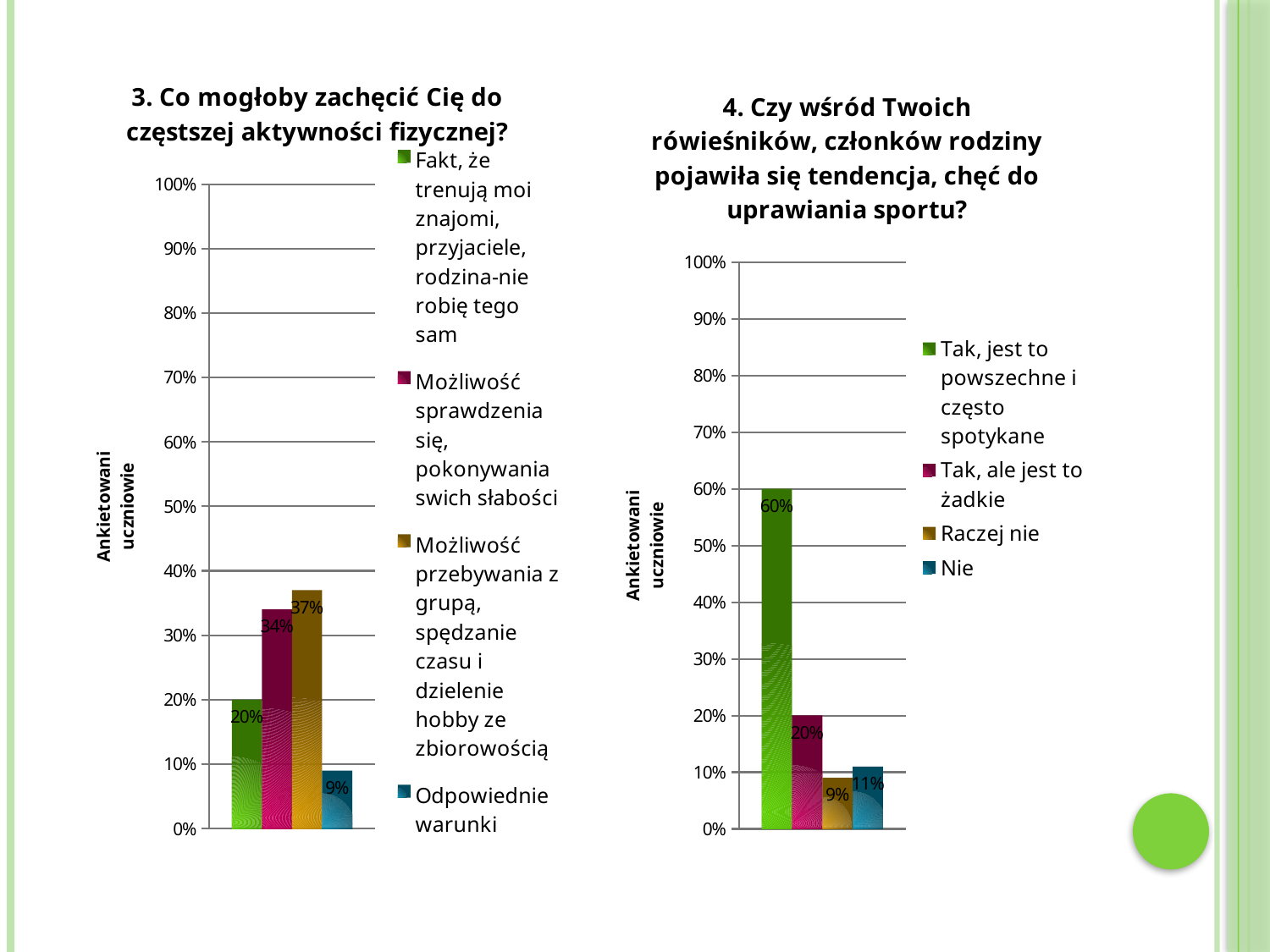
In the chart titled "3. Co mogłoby zachęcić Cię do częstszej aktywności fizycznej?", what is the value for "Możliwość sprawdzenia się, pokonywania swich słabości"? 34% In the chart titled "4. Czy wśród Twoich rówieśników, członków rodziny pojawiła się tendencja, chęć do uprawiania sportu?", what is the value for "Tak, jest to powszechne i często spotykane"? 60% In the chart titled "4. Czy wśród Twoich rówieśników, członków rodziny pojawiła się tendencja, chęć do uprawiania sportu?", what is the value for "Nie"? 11% In the chart titled "3. Co mogłoby zachęcić Cię do częstszej aktywności fizycznej?", how many series does the legend list? 4 What is the vertical axis title of the chart on the left side of the slide? Ankietowani uczniowie In the chart titled "3. Co mogłoby zachęcić Cię do częstszej aktywności fizycznej?", what is the difference between the values for "Możliwość przebywania z grupą..." and "Fakt, że trenują moi znajomi..."? 17% In the chart titled "3. Co mogłoby zachęcić Cię do częstszej aktywności fizycznej?", what is the value for "Odpowiednie warunki"? 9% In the chart titled "4. Czy wśród Twoich rówieśników, członków rodziny pojawiła się tendencja, chęć do uprawiania sportu?", which legend entry has the lowest value? Raczej nie What kind of chart is the chart on the right side of the slide? Bar chart In the chart titled "4. Czy wśród Twoich rówieśników, członków rodziny pojawiła się tendencja, chęć do uprawiania sportu?", what is the difference between the values for "Tak, jest to powszechne i często spotykane" and "Tak, ale jest to żadkie"? 40% In the chart titled "4. Czy wśród Twoich rówieśników, członków rodziny pojawiła się tendencja, chęć do uprawiania sportu?", which is larger, the value for "Nie" or the value for "Raczej nie"? Nie In the chart titled "3. Co mogłoby zachęcić Cię do częstszej aktywności fizycznej?", which legend entry has the highest value? Możliwość przebywania z grupą, spędzanie czasu i dzielenie hobby ze zbiorowością